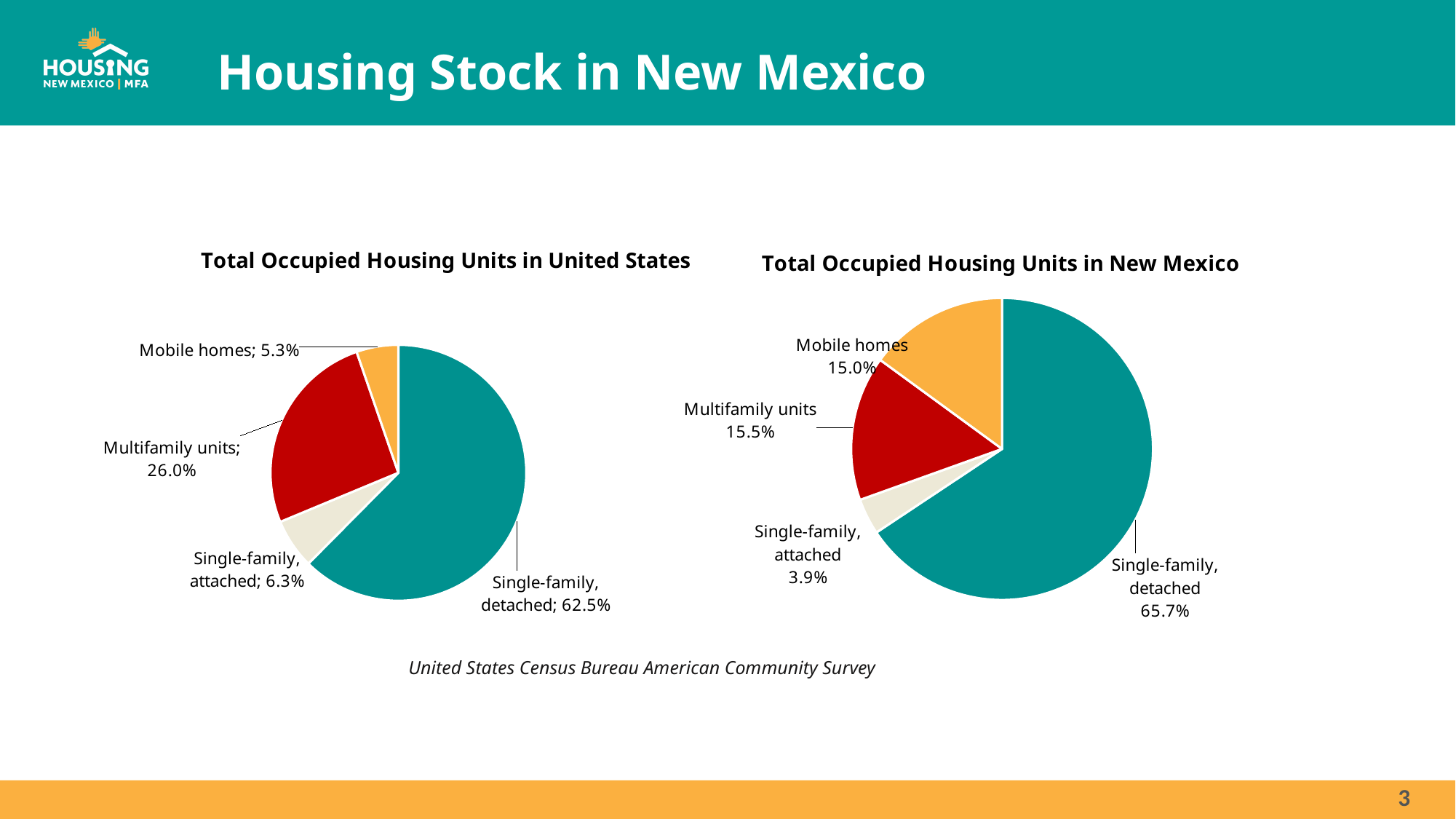
In the 'Total Occupied Housing Units in New Mexico' chart, what colour is the Mobile homes slice? Orange In the 'Total Occupied Housing Units in New Mexico' chart, what is the difference between the Single-family, detached share and the Multifamily units share? 50.2% What is the difference between the Mobile homes share in the New Mexico chart and the Mobile homes share in the United States chart? 9.7% In the 'Total Occupied Housing Units in United States' chart, what share is Multifamily units? 26.0% In the 'Total Occupied Housing Units in United States' chart, which category has the largest share? Single-family, detached How many categories are shown in the 'Total Occupied Housing Units in New Mexico' chart? 4 Which is larger: the Multifamily units share in the United States chart or the Multifamily units share in the New Mexico chart? United States chart What kind of chart is 'Total Occupied Housing Units in United States'? Pie chart In the 'Total Occupied Housing Units in New Mexico' chart, what share is Single-family, attached? 3.9% In the 'Total Occupied Housing Units in New Mexico' chart, what share is Mobile homes? 15.0% In the 'Total Occupied Housing Units in New Mexico' chart, which category has the smallest share? Single-family, attached In the 'Total Occupied Housing Units in United States' chart, which category has the smallest share? Mobile homes